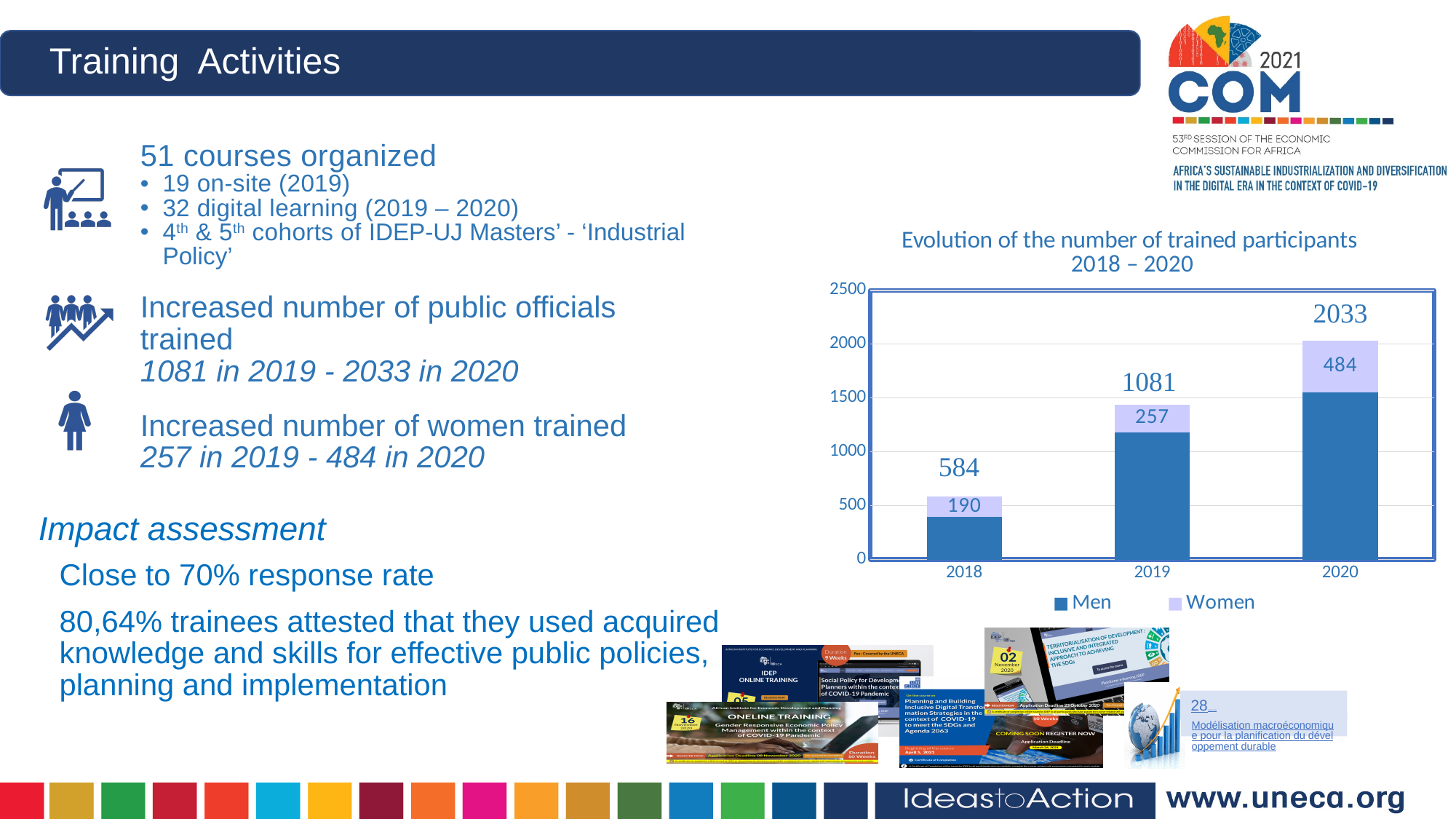
What is the number of women trained in 2018 according to the chart? 190 How many series does the chart legend list? 2 What kind of chart is shown on the slide? Stacked bar chart How many years are shown on the x axis of the chart? 3 What is the title of the chart? Evolution of the number of trained participants 2018 – 2020 What is the total number of trained participants in 2019 according to the chart? 1081 Which year has the highest total number of trained participants? 2020 What is the number of women trained in 2020 according to the chart? 484 Does the total number of trained participants rise or fall from 2018 to 2020? Rise What is the total number of trained participants in 2018 according to the chart? 584 What is the difference between the total number of trained participants in 2020 and in 2019? 952 Which year has the lowest number of women trained? 2018